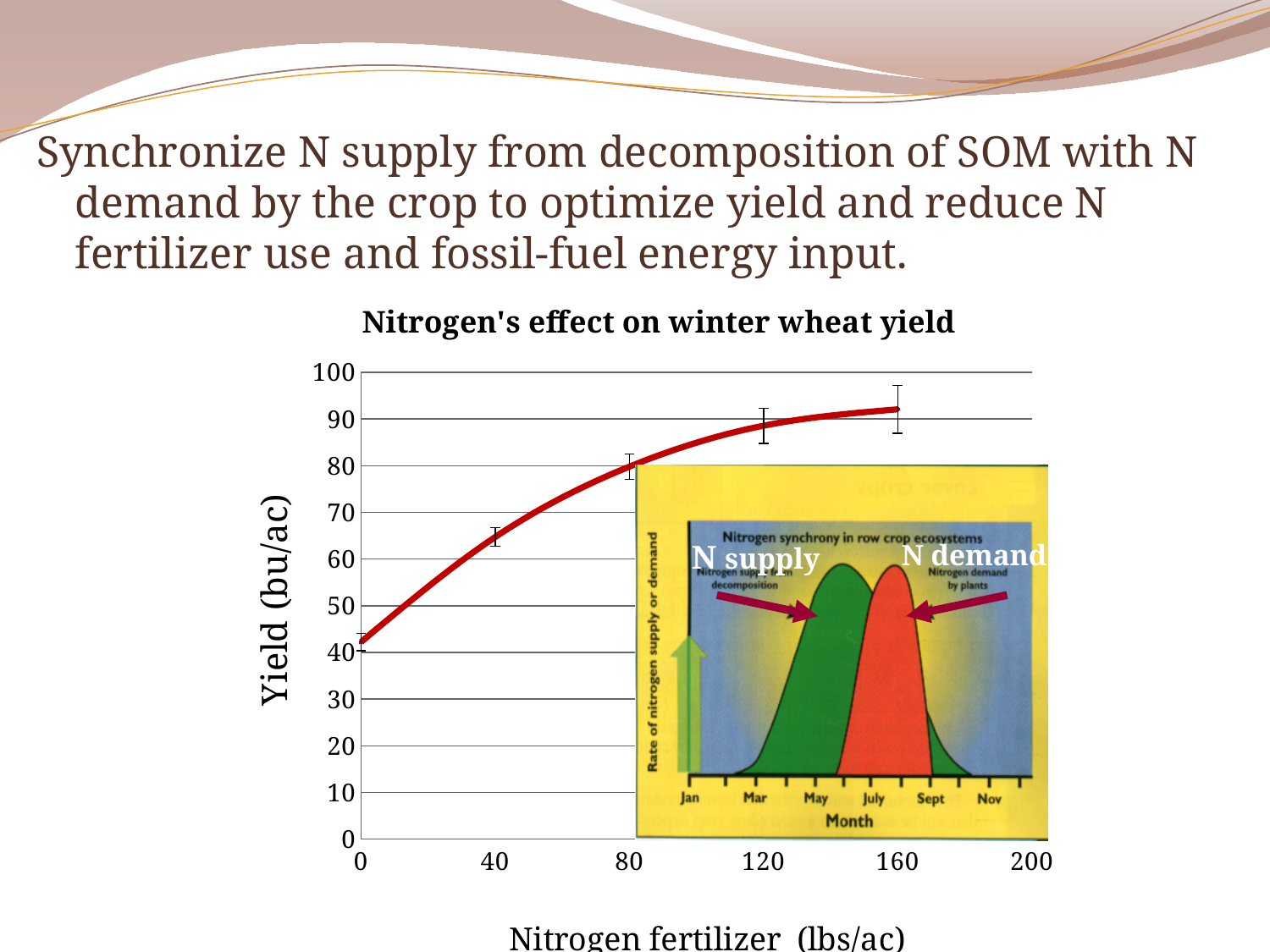
What is the title of the chart on the slide? Nitrogen's effect on winter wheat yield What kind of chart is 'Nitrogen's effect on winter wheat yield'? line chart As nitrogen fertilizer increases along the x axis, does the yield rise or fall? rise Is the yield at 160 lbs/ac of nitrogen fertilizer greater or less than 80? greater At which nitrogen fertilizer level is the yield lowest? 0 Which has the higher yield: 40 lbs/ac or 120 lbs/ac of nitrogen fertilizer? 120 lbs/ac Is the yield at 40 lbs/ac of nitrogen fertilizer greater or less than 60? greater How many data points with error bars are plotted on the yield curve? 5 What is the label of the y axis of the chart? Yield (bu/ac) Is the yield at 80 lbs/ac of nitrogen fertilizer greater or less than 70? greater At which nitrogen fertilizer level is the yield highest? 160